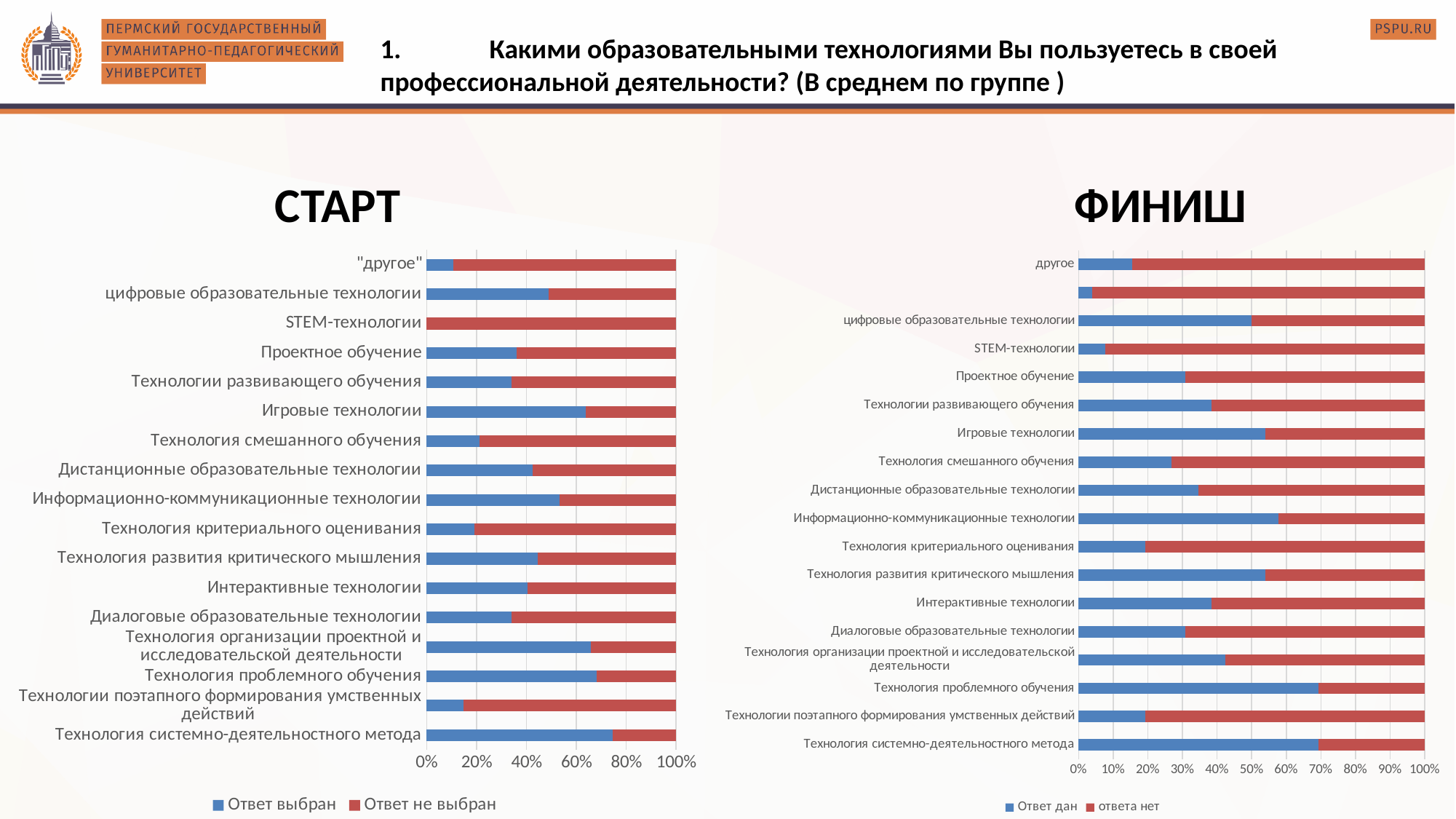
On the СТАРТ chart, which has the larger 'Ответ выбран' share: Игровые технологии or Технология смешанного обучения? Игровые технологии What kind of chart is the СТАРТ chart on the left? Stacked horizontal bar chart On the ФИНИШ chart, which has the larger 'Ответ дан' share: Технология проблемного обучения or STEM-технологии? Технология проблемного обучения How many categories are shown on the СТАРТ chart? 17 On the СТАРТ chart, is the 'Ответ выбран' share for Технологии поэтапного формирования умственных действий greater or less than 20%? less On the ФИНИШ chart, is the 'Ответ дан' share for STEM-технологии greater or less than 10%? less How many series does the legend of the ФИНИШ chart list? 2 What are the two legend entries of the СТАРТ chart? Ответ выбран, Ответ не выбран On the СТАРТ chart, which category has the lowest share of 'Ответ выбран'? STEM-технологии On the ФИНИШ chart, is the 'Ответ дан' share for Информационно-коммуникационные технологии greater or less than 50%? greater On the СТАРТ chart, which category has the highest share of 'Ответ выбран'? Технология системно-деятельностного метода